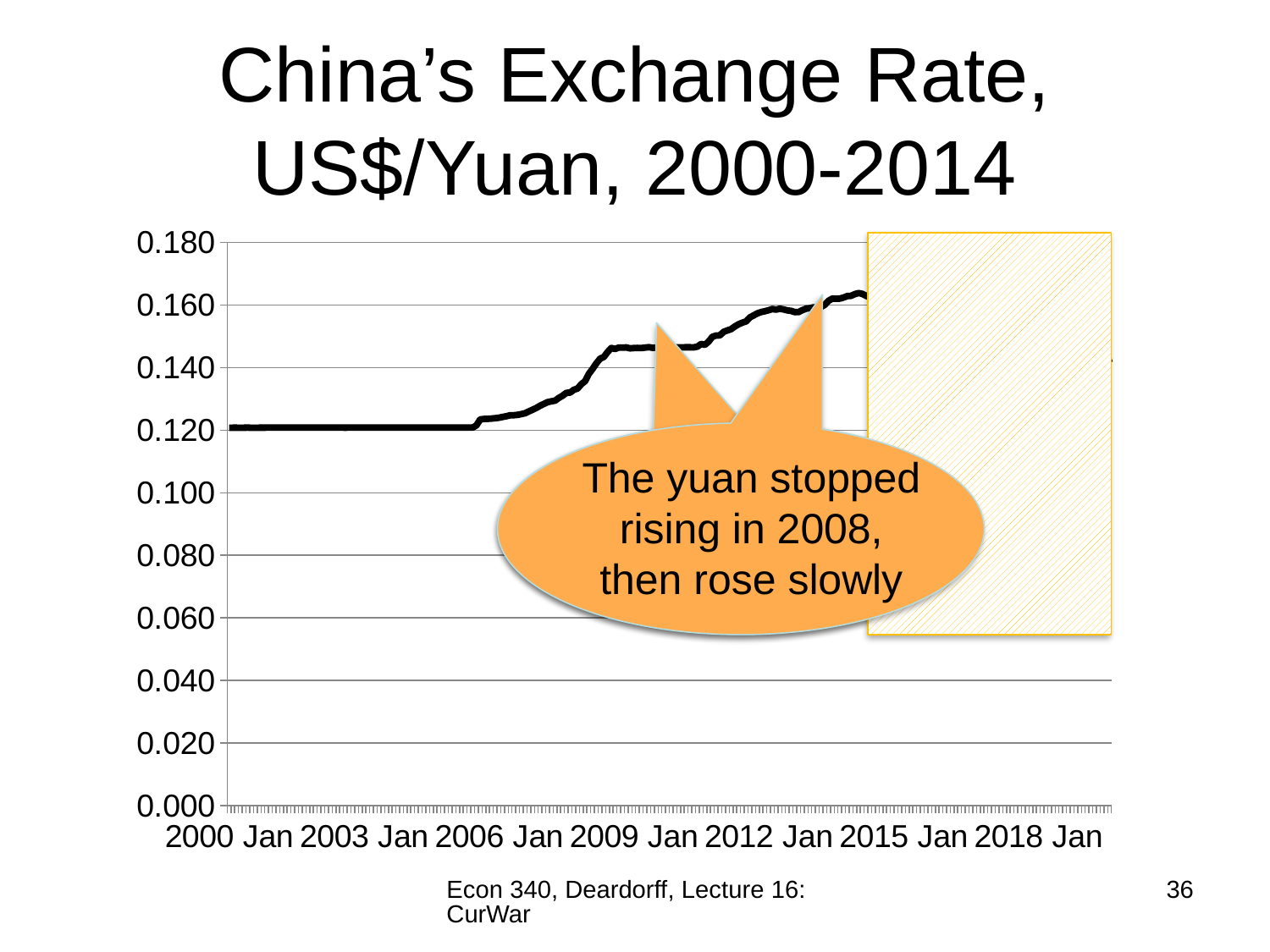
Is the exchange rate in 2006 Jan greater or less than 0.140? less What is the highest value shown on the vertical axis? 0.180 Overall, does the exchange rate rise or fall from 2000 to 2014? rise Is the exchange rate in 2012 Jan greater or less than 0.140? greater What kind of chart is shown on the slide? line chart Is the exchange rate in 2003 Jan greater or less than 0.140? less Does the exchange rate rise or fall between 2006 Jan and 2009 Jan? rise Which is larger, the exchange rate in 2003 Jan or in 2012 Jan? 2012 Jan What is the title of the chart? China's Exchange Rate, US$/Yuan, 2000-2014